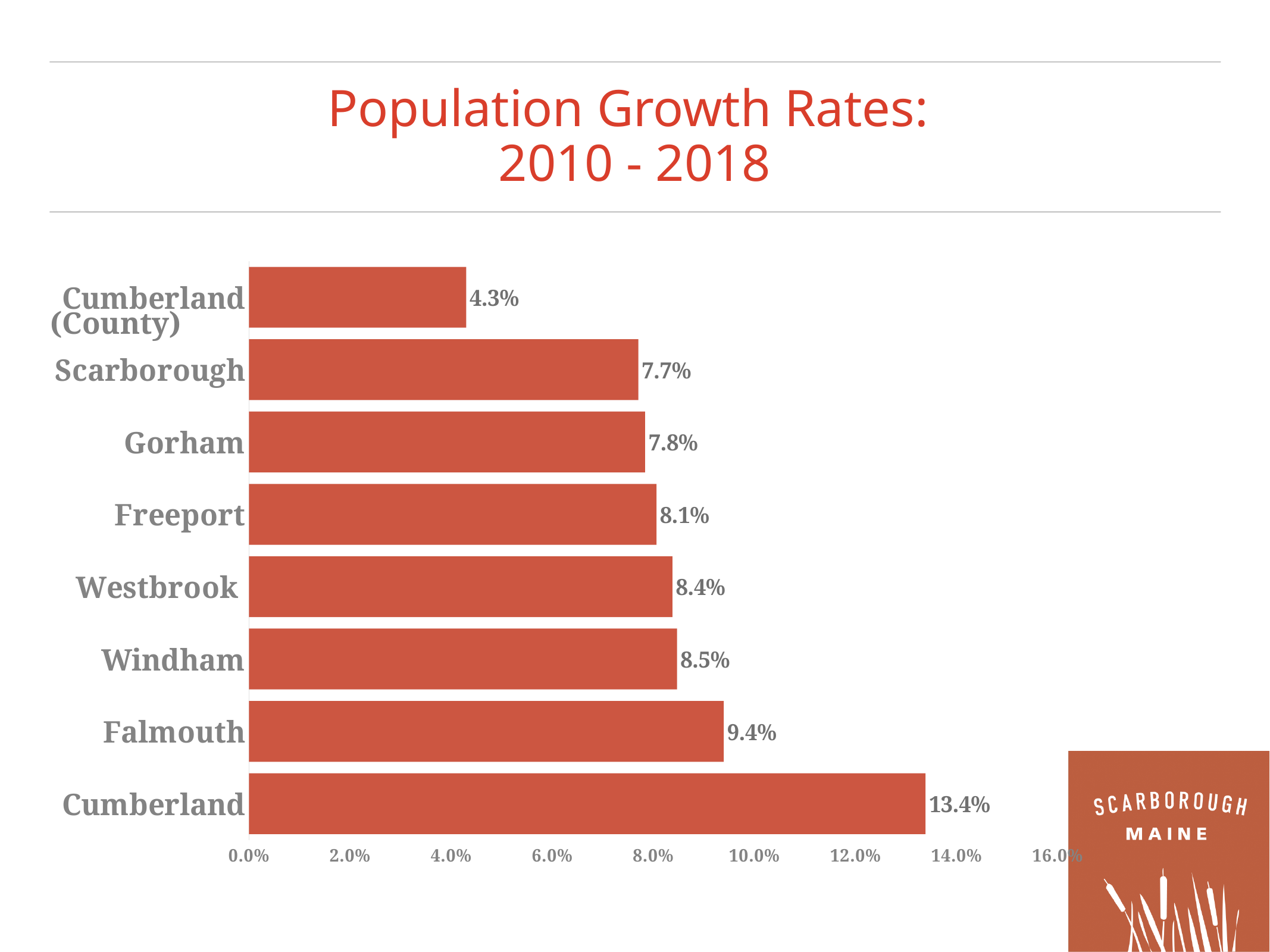
What is the population growth rate for Cumberland (County)? 4.3% What is the population growth rate for Falmouth? 9.4% Which has a higher growth rate, Westbrook or Freeport? Westbrook What is the population growth rate for Scarborough? 7.7% What is the difference between the growth rates of Cumberland and Falmouth? 4.0% What is the title of the chart on the slide? Population Growth Rates: 2010 - 2018 What is the difference between the growth rates of Scarborough and Cumberland (County)? 3.4% What kind of chart is shown on the slide? bar chart How many categories are shown in the chart? 8 Which category has the lowest population growth rate? Cumberland (County) Which category has the highest population growth rate? Cumberland Is the value for Windham greater or less than 10.0%? less